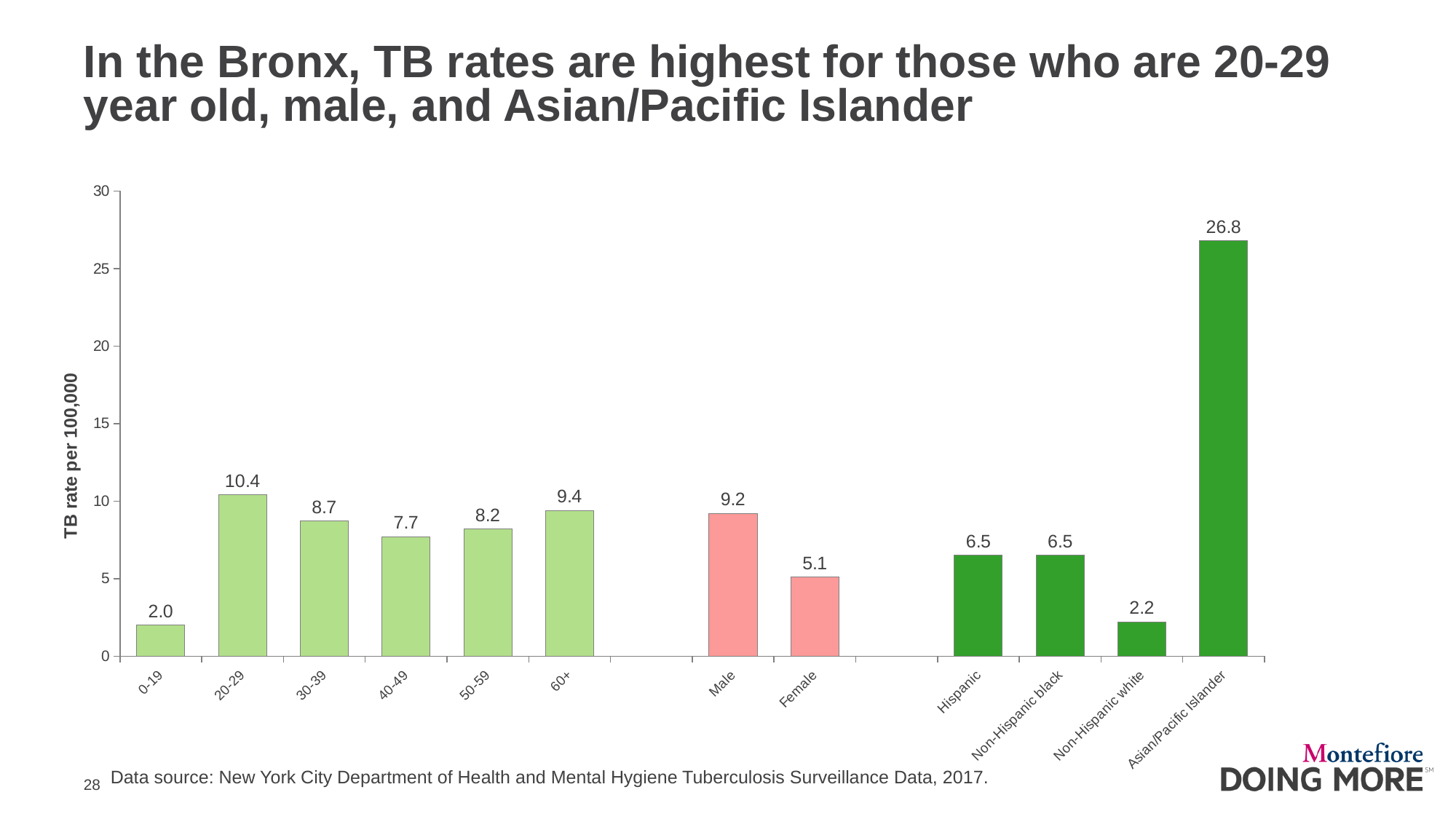
What is the label of the vertical axis? TB rate per 100,000 What is the difference between the TB rates for Asian/Pacific Islander and Non-Hispanic white? 24.6 What is the difference between the TB rates for Male and Female? 4.1 Which has a higher TB rate, the 60+ age group or the 50-59 age group? 60+ How many bars are plotted on the chart? 12 What type of chart is shown on the slide? bar chart What is the TB rate per 100,000 for Asian/Pacific Islander? 26.8 What is the TB rate per 100,000 for Female? 5.1 Which category has the highest TB rate on the chart? Asian/Pacific Islander Which category has the lowest TB rate on the chart? 0-19 Is the TB rate for Asian/Pacific Islander greater or less than 25? greater What is the TB rate per 100,000 for the 20-29 age group? 10.4